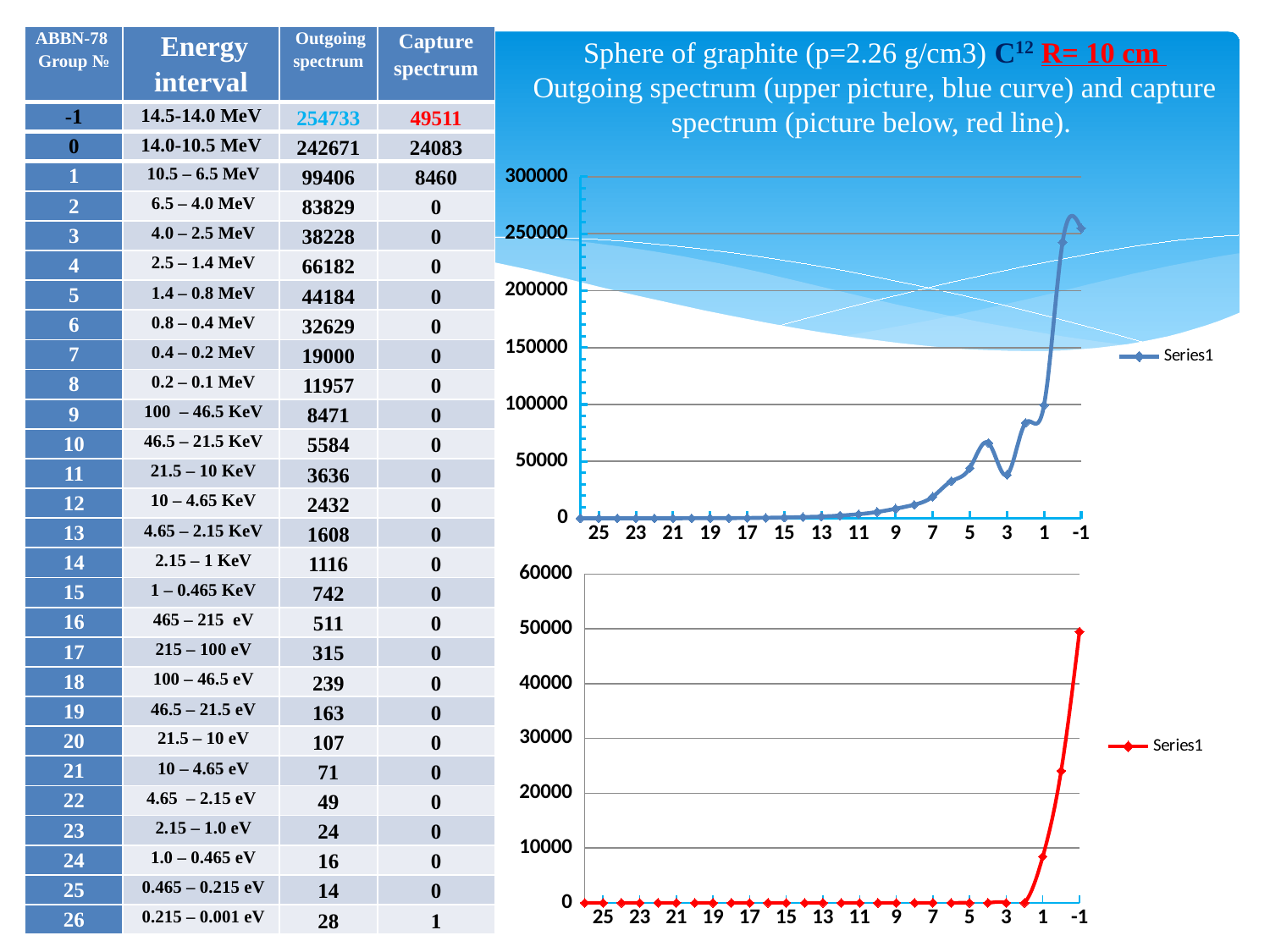
In the upper chart, is the value at x = 5 greater or less than 100000? less What is the legend entry shown for the lower chart? Series1 In the upper chart, is the value at x = 15 greater or less than 50000? less In the upper chart, is the value at x = -1 greater or less than 200000? greater How many series does the legend of the upper chart list? 1 What kind of chart is the upper chart on the slide? line chart What colour is the line in the lower chart? red In the lower chart, do the values generally rise or fall moving from x = 25 to x = -1? rise In the upper chart, which is larger: the value at x = 1 or the value at x = 5? x = 1 What kind of chart is the lower chart on the slide? line chart